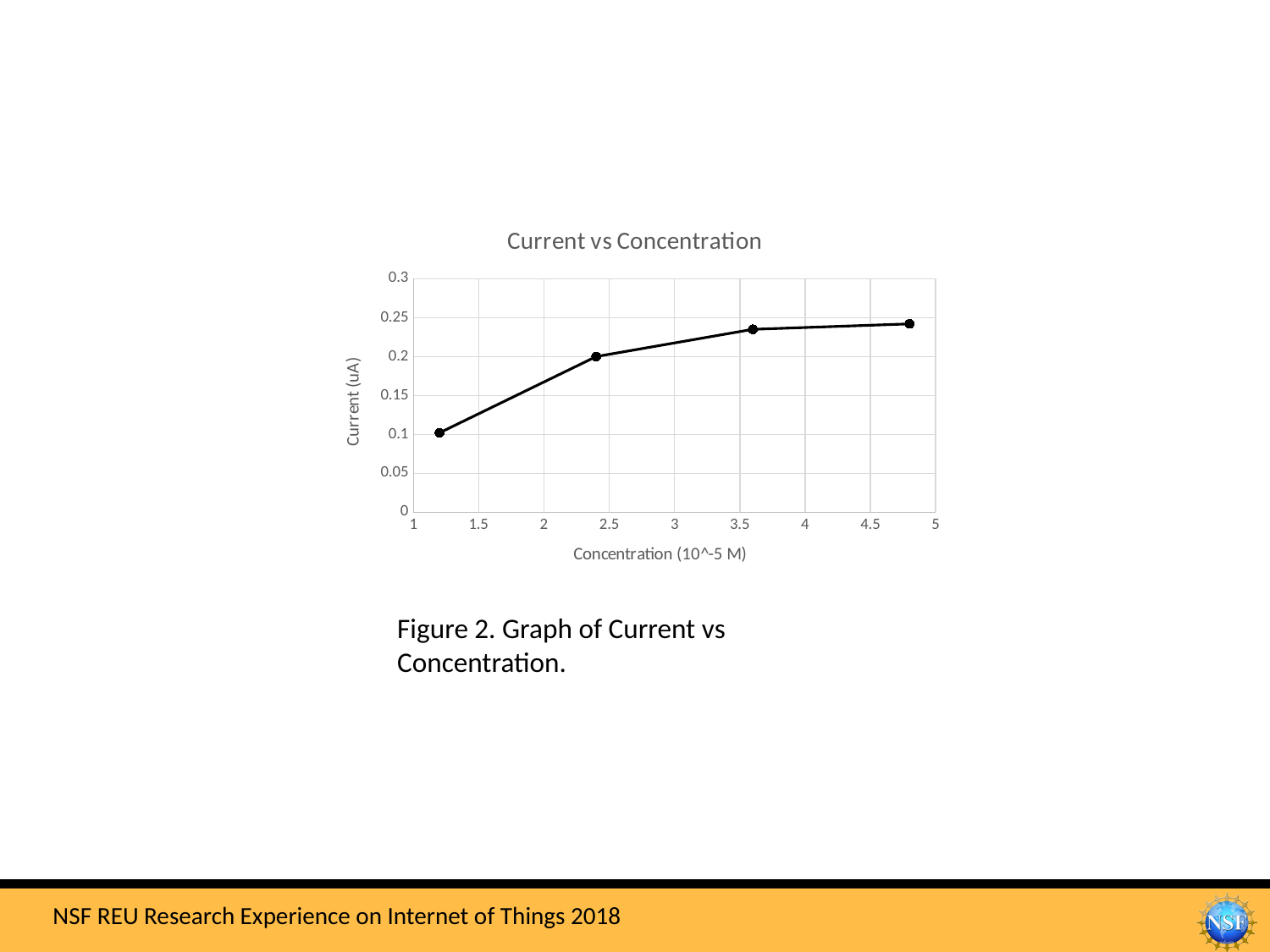
Is the current for the third data point from the left greater or less than 0.25? less Which data point has the lowest current? the leftmost point Is the current for the rightmost data point greater or less than 0.2? greater What is the label of the y axis? Current (uA) Which has the larger current, the leftmost data point or the second data point from the left? the second data point from the left What kind of chart is shown on the slide? line chart Does the current rise or fall as concentration increases along the x axis? rise What is the title of the chart? Current vs Concentration Is the current for the leftmost data point greater or less than 0.15? less How many data points are plotted on the Current vs Concentration chart? 4